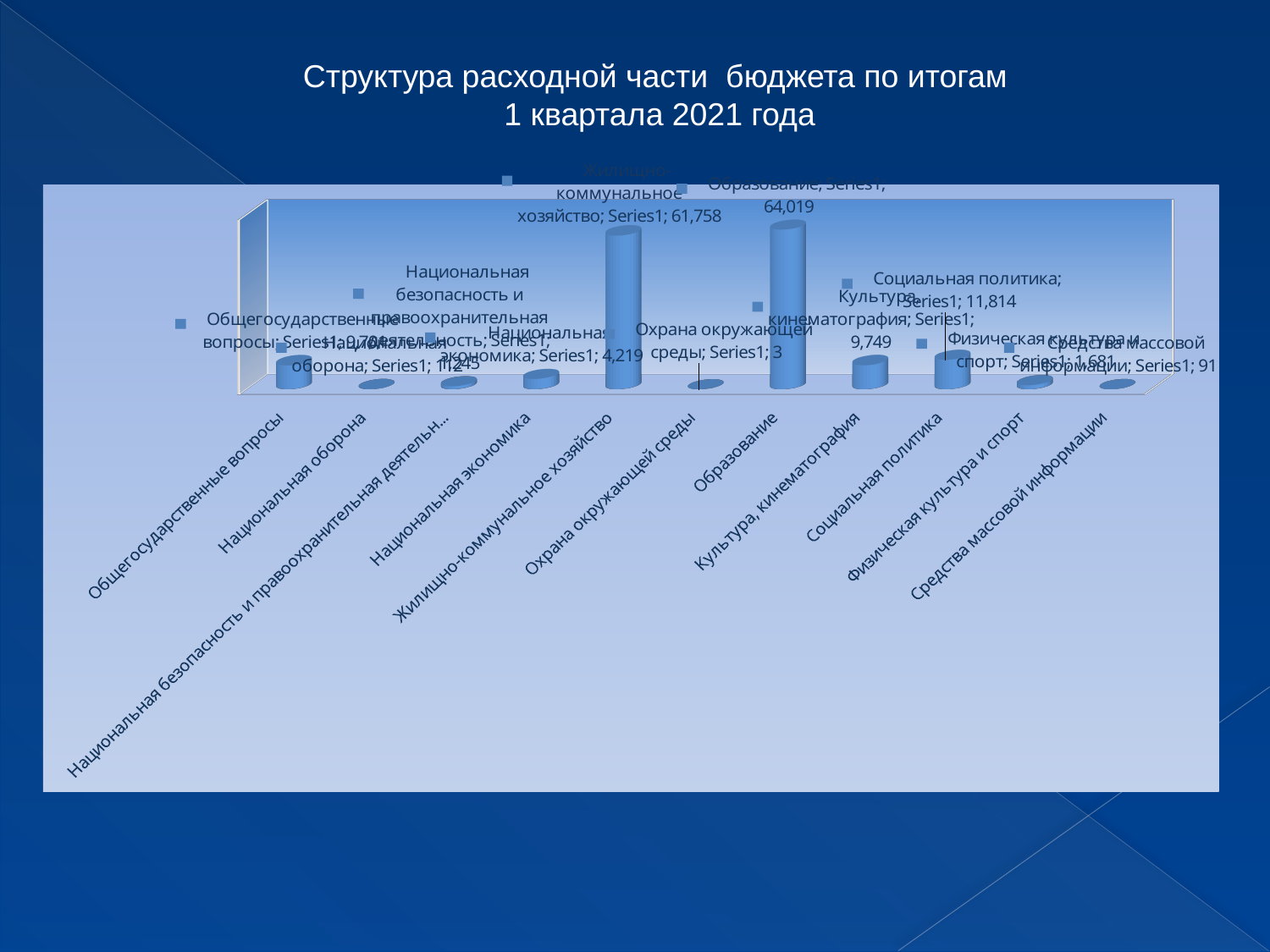
What is the difference between the values for Образование and Жилищно-коммунальное хозяйство? 2,261 How many categories are shown on the chart? 11 What is the value for Средства массовой информации? 91 What is the value for Жилищно-коммунальное хозяйство? 61,758 What is the title of the chart? Структура расходной части бюджета по итогам 1 квартала 2021 года What kind of chart is shown on the slide? bar chart Which category has the highest value? Образование Which category has the lowest value? Охрана окружающей среды What is the value for Культура, кинематография? 9,749 What is the value for Социальная политика? 11,814 What is the value for Образование? 64,019 What is the value for Национальная экономика? 4,219